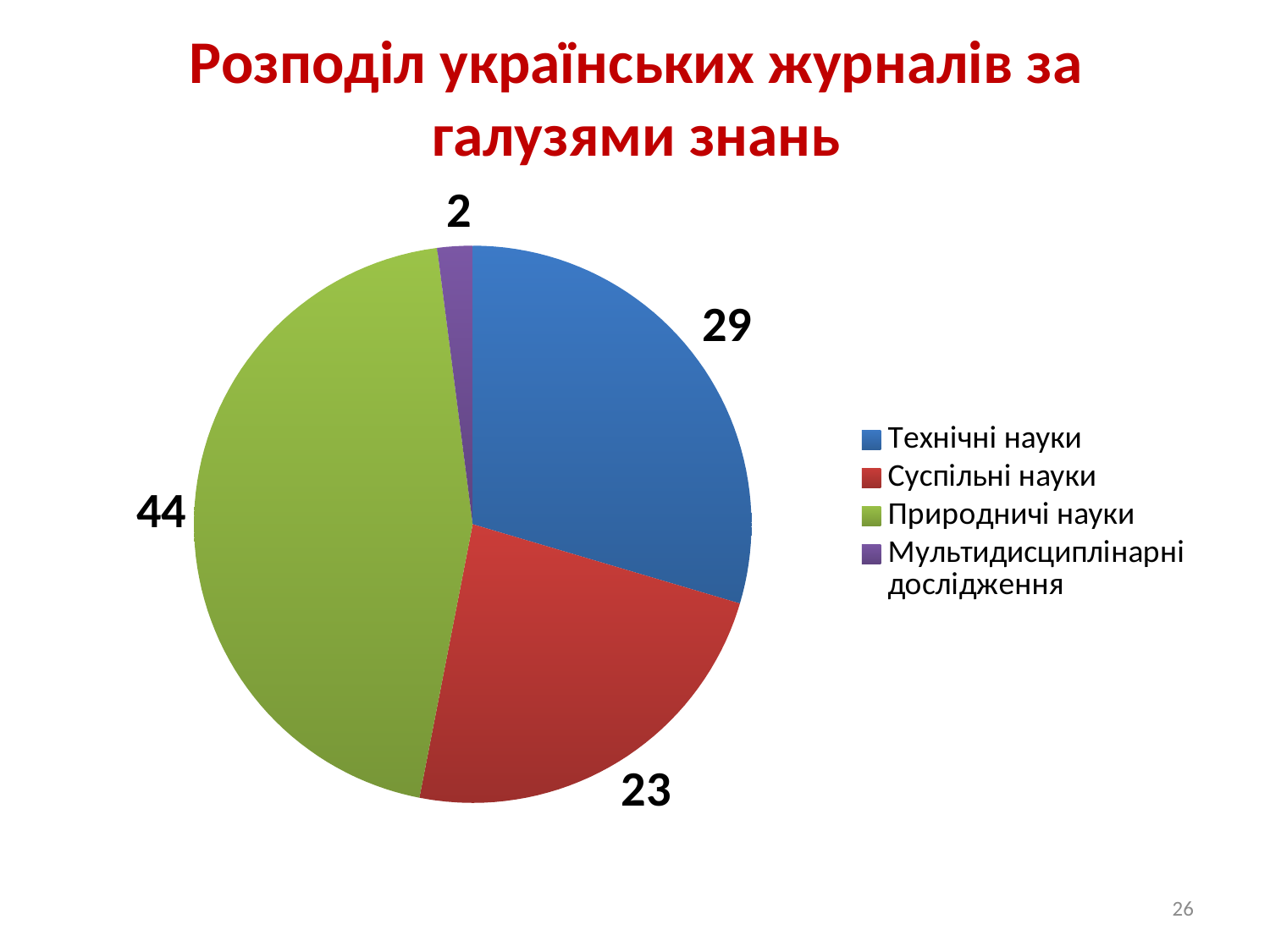
What is the value for Суспільні науки? 23 How many categories does the pie chart have? 4 Which category has the largest slice of the pie? Природничі науки What type of chart is shown on the slide? pie chart What is the value for Мультидисциплінарні дослідження? 2 What is the title of the chart? Розподіл українських журналів за галузями знань Which is larger, the value for Технічні науки or the value for Суспільні науки? Технічні науки What is the value for Технічні науки? 29 Which category has the smallest slice of the pie? Мультидисциплінарні дослідження What is the difference between the values for Технічні науки and Суспільні науки? 6 What is the value for Природничі науки? 44 What is the difference between the values for Природничі науки and Технічні науки? 15